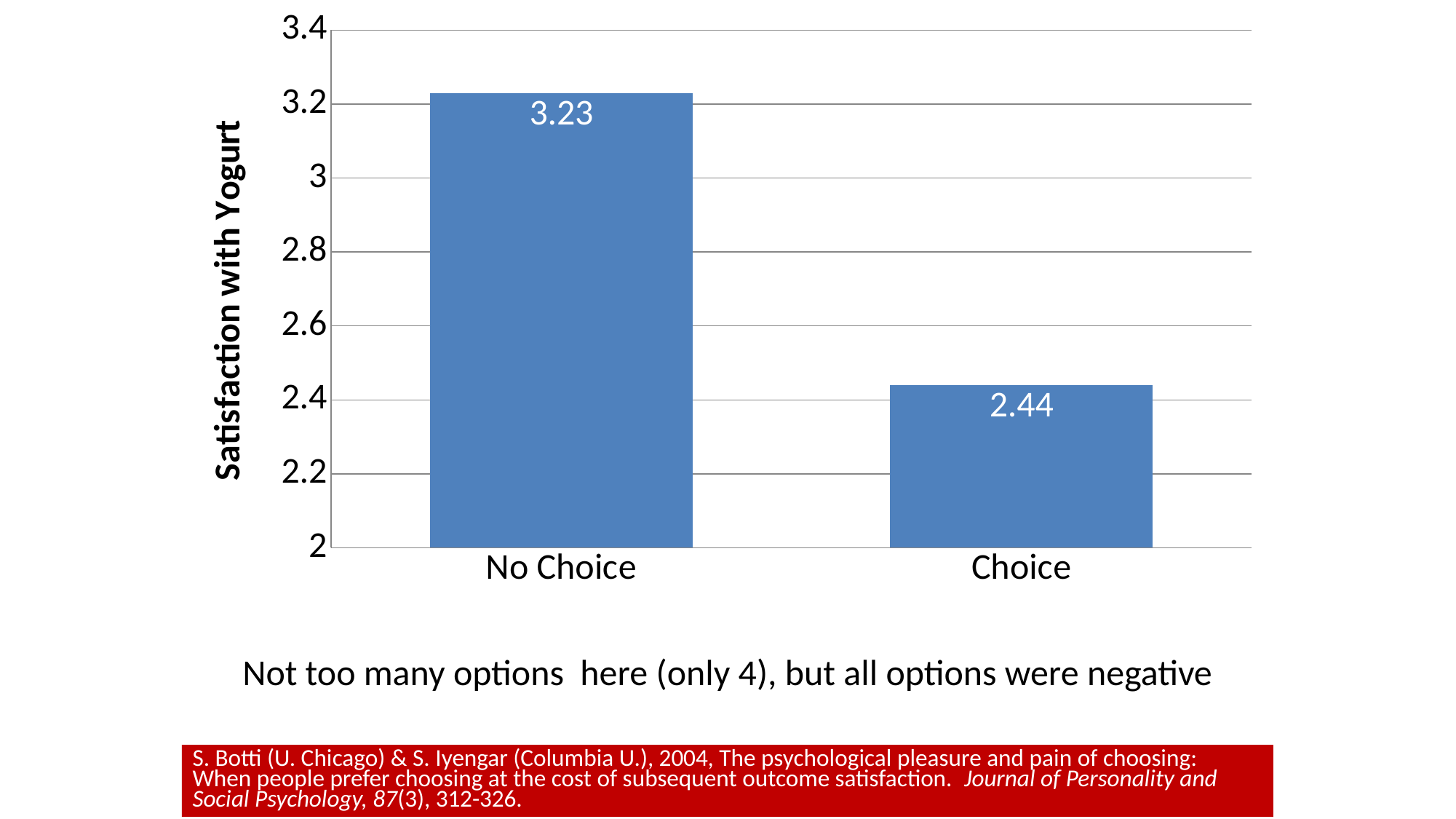
Is the value for No Choice greater or less than 3? greater Which has a higher satisfaction with yogurt, No Choice or Choice? No Choice What kind of chart is shown on the slide? bar chart How many categories are shown on the x axis? 2 What is the satisfaction with yogurt value for the No Choice condition? 3.23 Which condition has the highest satisfaction with yogurt? No Choice What is the satisfaction with yogurt value for the Choice condition? 2.44 Is the value for Choice greater or less than 2.6? less What is the difference in satisfaction with yogurt between No Choice and Choice? 0.79 What is the label of the vertical axis? Satisfaction with Yogurt Which condition has the lowest satisfaction with yogurt? Choice What is the lowest value shown on the vertical axis? 2